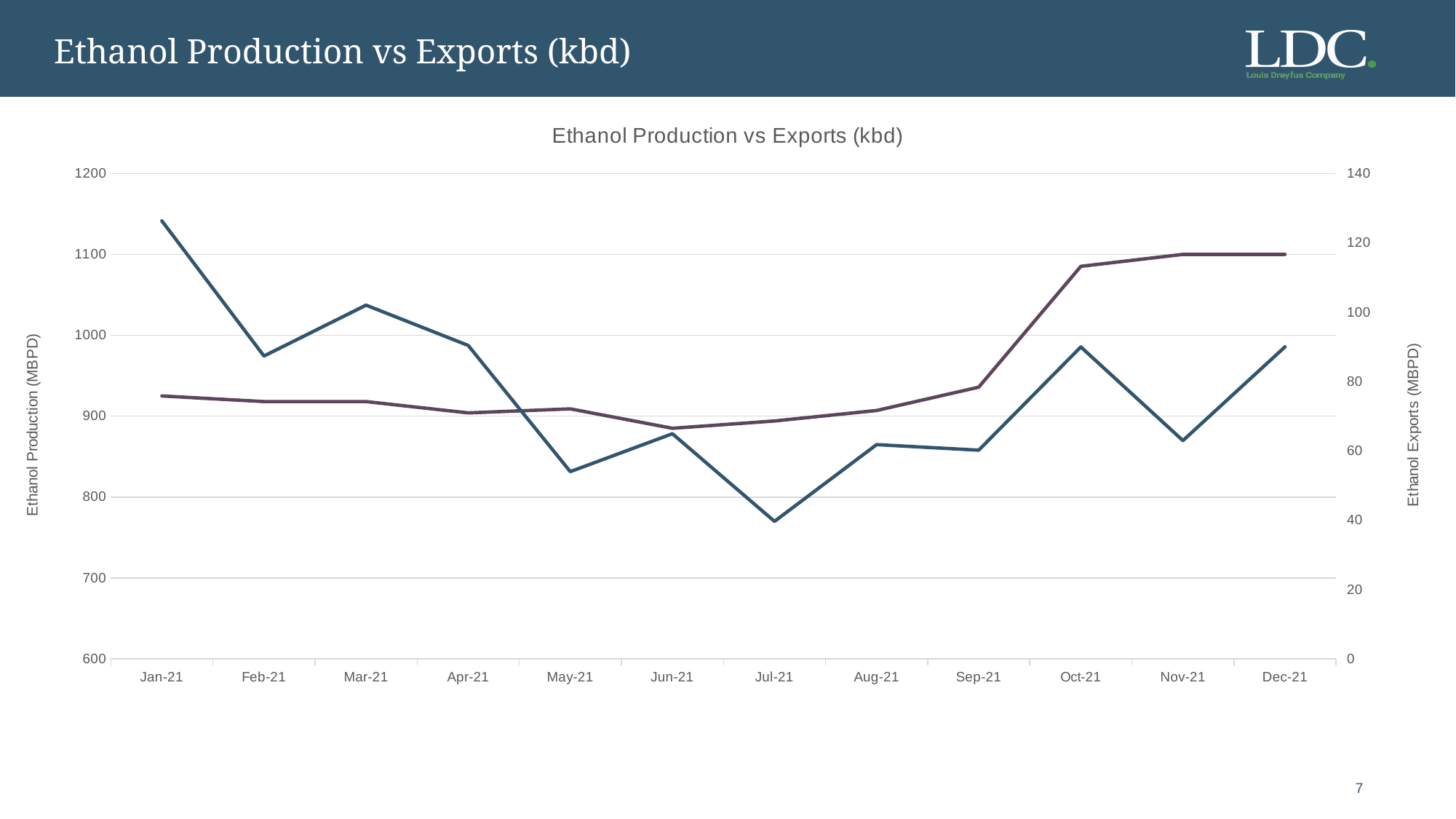
How many months are plotted along the x axis? 12 Is the Ethanol Exports value for Jun-21 greater or less than 80? less What is the label on the right-hand vertical axis? Ethanol Exports (MBPD) What kind of chart is shown on the slide? line chart What is the title of the chart? Ethanol Production vs Exports (kbd)